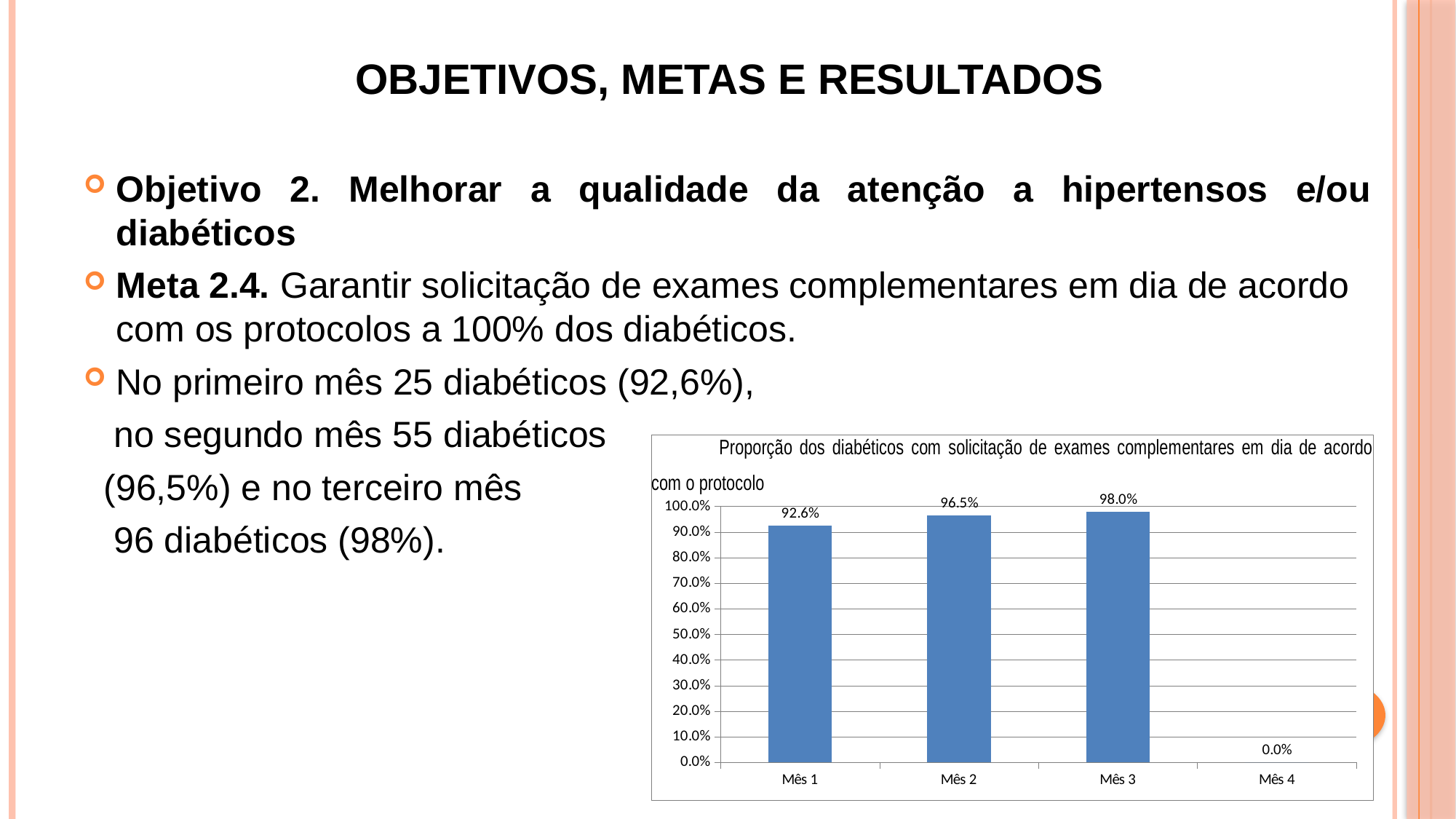
Do the values rise or fall from Mês 1 to Mês 3? rise What is the difference between the values for Mês 3 and Mês 1? 5.4% What is the value for Mês 3? 98.0% What is the value for Mês 1? 92.6% Which is larger, the value for Mês 1 or the value for Mês 2? Mês 2 Is the value for Mês 1 greater or less than 90.0%? greater How many months are shown on the x axis? 4 What kind of chart is shown on the slide? bar chart Which month has the highest value? Mês 3 What is the value for Mês 4? 0.0% What is the value for Mês 2? 96.5% Which month has the lowest value? Mês 4